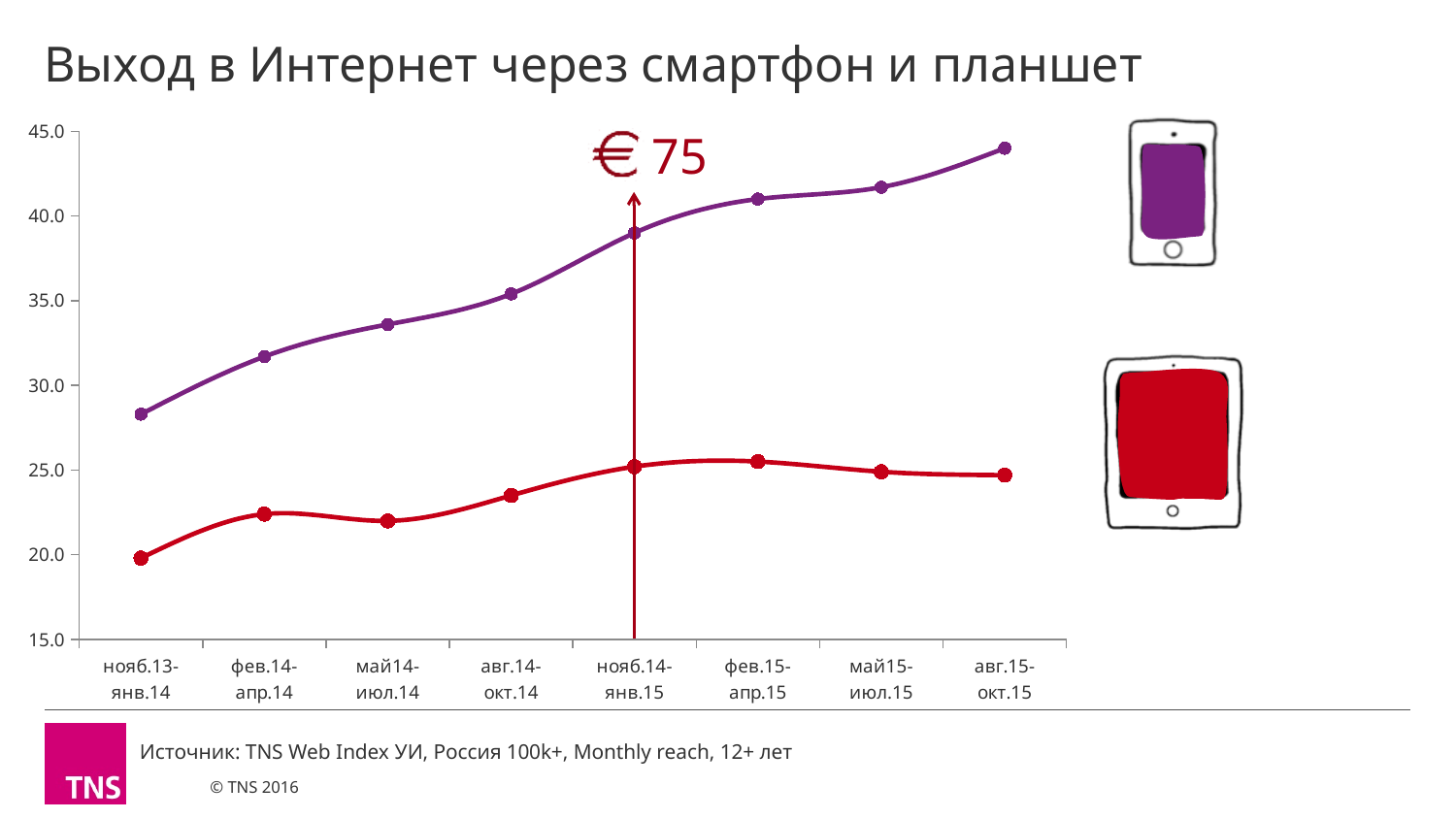
Is the value of the purple line for ноя.14-янв.15 greater or less than 35? greater What is the title of the chart? Выход в Интернет через смартфон и планшет Which line has the higher value for май15-июл.15, the purple line or the red line? the purple line Is the value of the red line for авг.14-окт.14 greater or less than 25? less In which period does the purple line reach its highest value? авг.15-окт.15 What kind of chart is shown on the slide? line chart How many lines are plotted on the chart? 2 Does the purple line rise or fall from ноя.13-янв.14 to авг.15-окт.15? rises Is the value of the purple line for авг.15-окт.15 greater or less than 40? greater How many time periods are plotted along the x axis? 8 In which period does the red line have its lowest value? ноя.13-янв.14